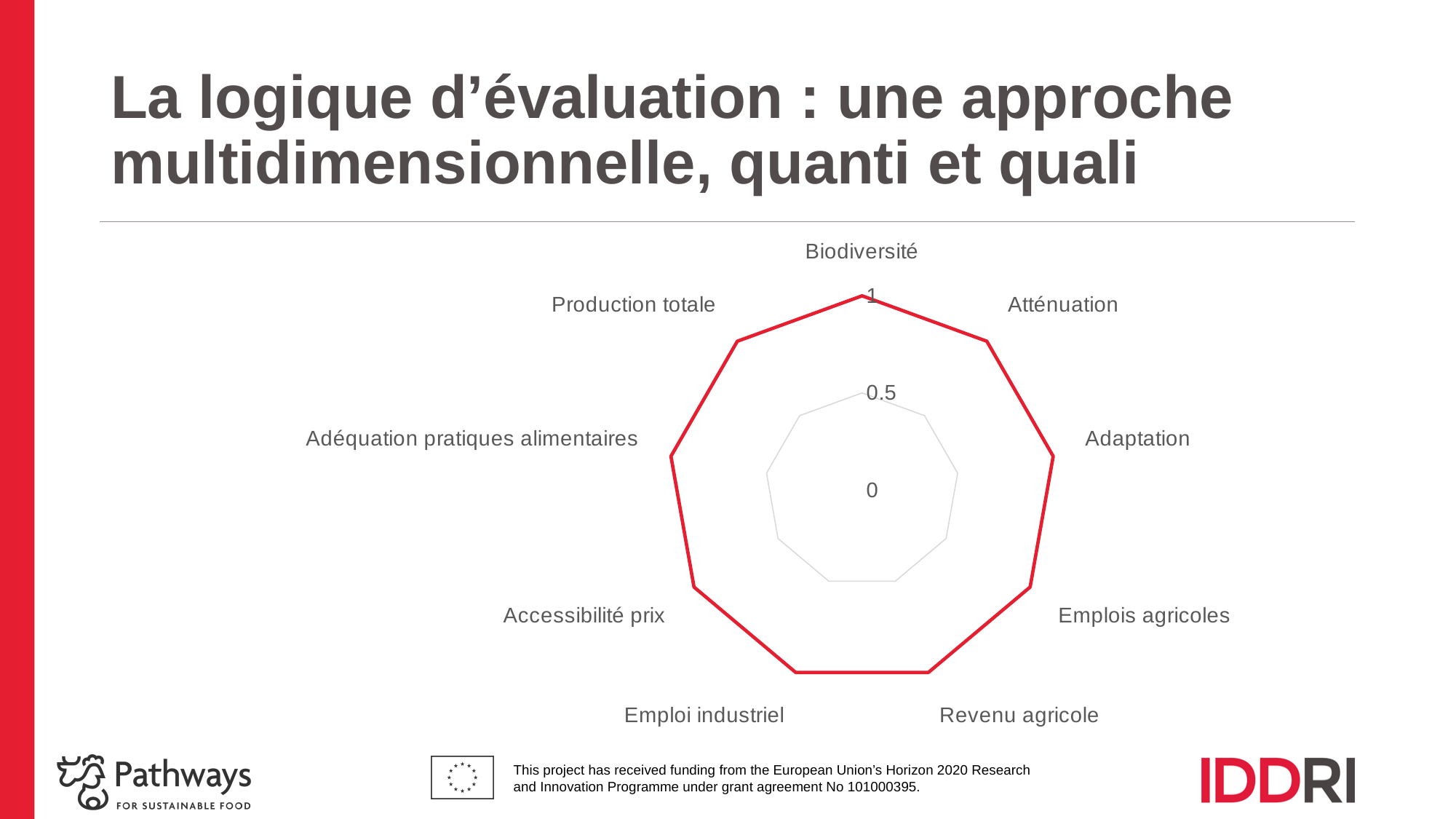
What is the highest value shown on the radar chart's scale? 1 What kind of chart is shown on the slide? Radar chart Is the value for Accessibilité prix greater or less than 0.5? greater Which category label appears at the top of the radar chart? Biodiversité What is the difference between the values for Atténuation and Emplois agricoles? 0 What is the value for Emploi industriel on the radar chart? 1 Is the value for Revenu agricole greater or less than 0.5? greater What colour is the data line on the radar chart? Red How many categories (axes) does the radar chart have? 9 What is the value for Production totale on the radar chart? 1 What is the value for Adaptation on the radar chart? 1 What is the value for Biodiversité on the radar chart? 1